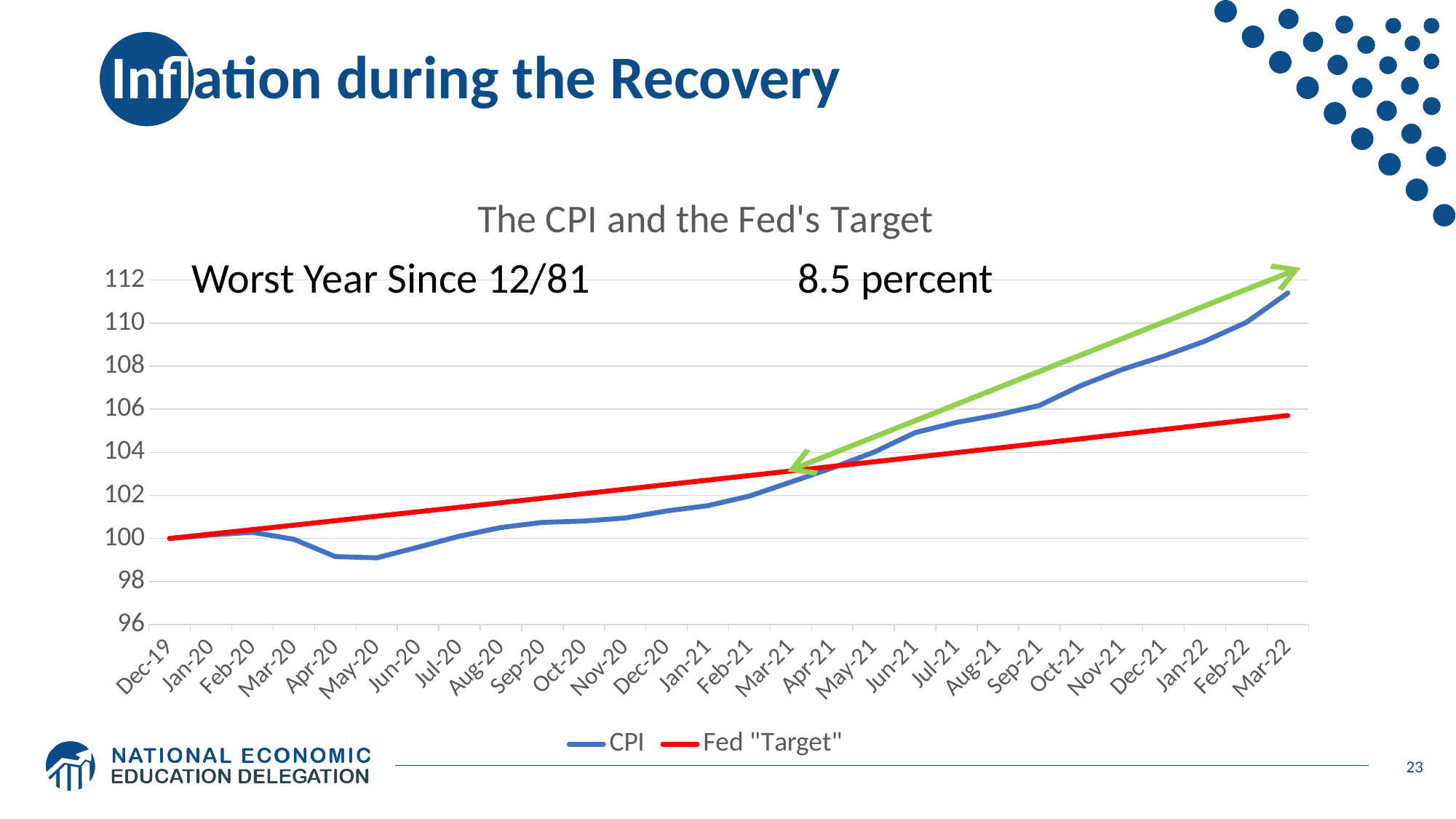
At Apr-20, which series has the higher value, CPI or Fed "Target"? Fed "Target" Is the CPI value at Mar-22 greater or less than 110? greater Is the CPI value at Apr-20 greater or less than 100? less Is the Fed "Target" value at Mar-22 greater or less than 106? less Does the Fed "Target" line rise or fall from Dec-19 to Mar-22? Rise What is the value of the CPI series at Dec-19? 100 At Mar-22, which series has the higher value, CPI or Fed "Target"? CPI What is the title of the chart? The CPI and the Fed's Target How many months are plotted along the x axis? 28 In which month does the CPI series reach its highest value? Mar-22 How many series does the legend list? 2 What kind of chart is shown on the slide? Line chart